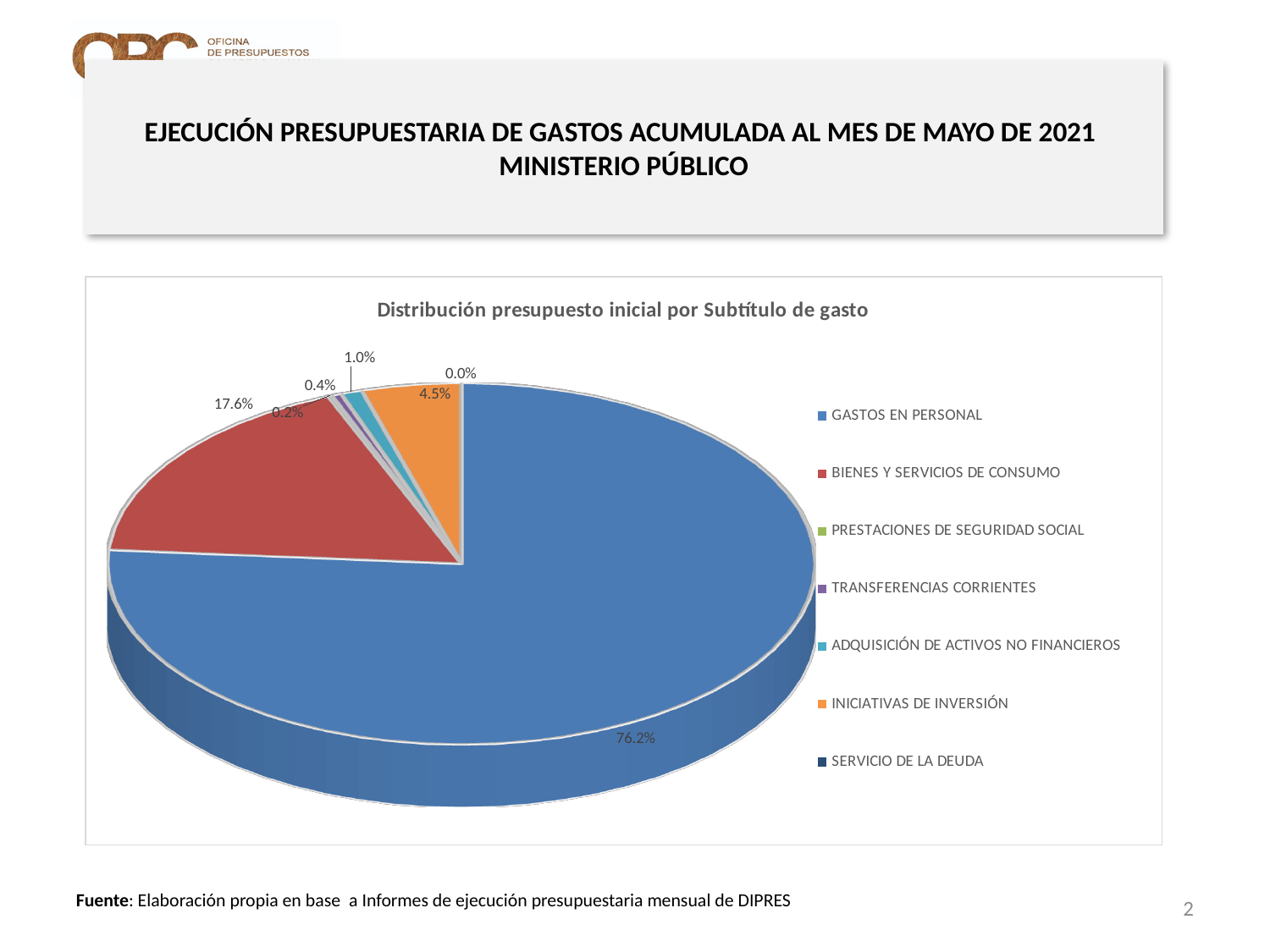
How many entries does the chart legend list? 7 What kind of chart is shown on the slide? pie chart Which category has the smallest slice of the pie? SERVICIO DE LA DEUDA Which category has the largest slice of the pie? GASTOS EN PERSONAL What share of the pie does INICIATIVAS DE INVERSIÓN represent? 4.5% What share of the pie does GASTOS EN PERSONAL represent? 76.2% What share of the pie does ADQUISICIÓN DE ACTIVOS NO FINANCIEROS represent? 1.0% Which is larger, the share for BIENES Y SERVICIOS DE CONSUMO or the share for INICIATIVAS DE INVERSIÓN? BIENES Y SERVICIOS DE CONSUMO What is the title of the chart? Distribución presupuesto inicial por Subtítulo de gasto What is the difference in percentage points between GASTOS EN PERSONAL and BIENES Y SERVICIOS DE CONSUMO? 58.6